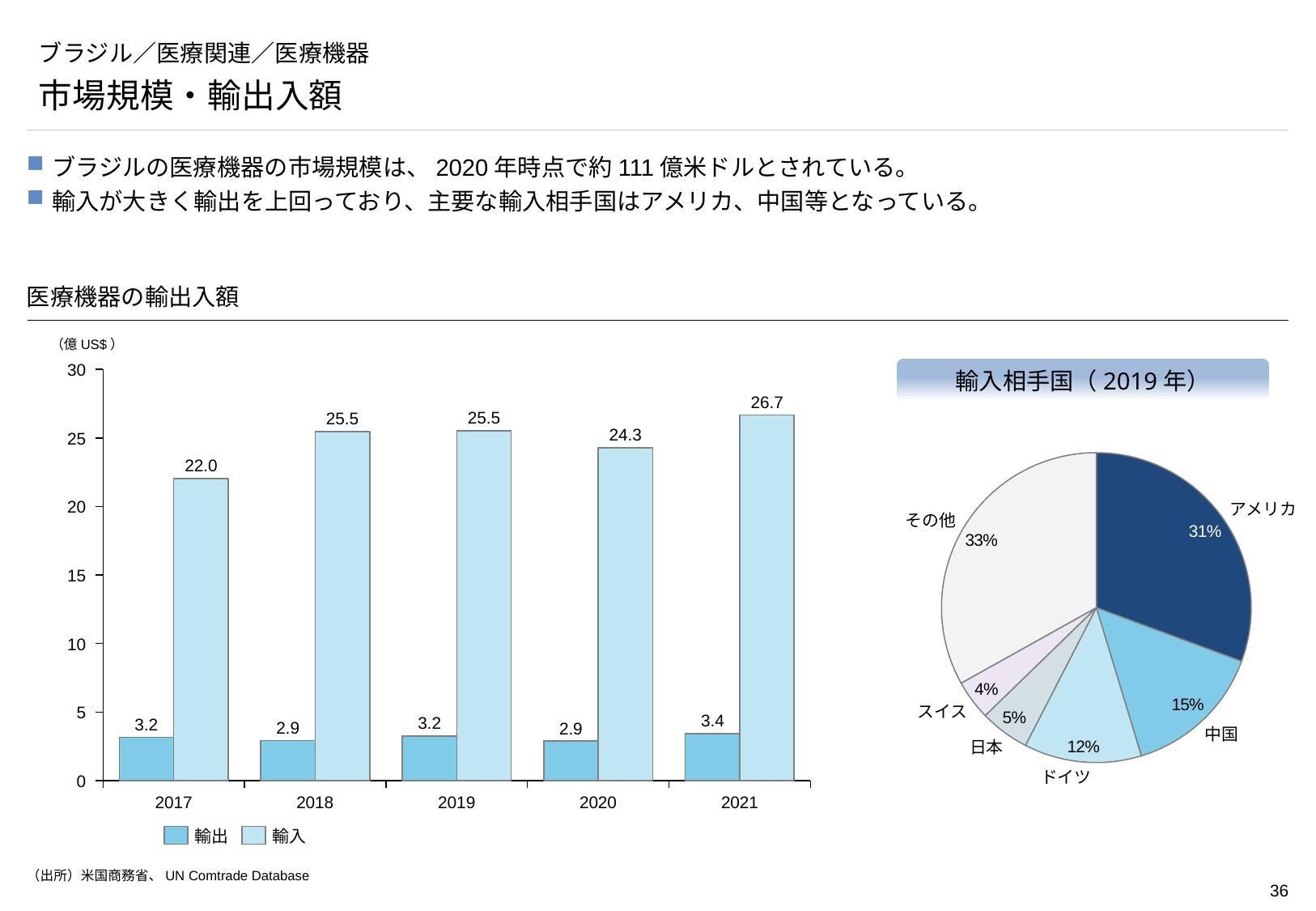
In the bar chart 医療機器の輸出入額, which year has the highest 輸入 value? 2021 In the bar chart 医療機器の輸出入額, how many series does the legend list? 2 In the bar chart 医療機器の輸出入額, what is the 輸出 value for 2018? 2.9 What type of chart is 医療機器の輸出入額? bar chart In the bar chart 医療機器の輸出入額, is the 輸出 value for 2021 larger or smaller than the 輸出 value for 2019? larger In the bar chart 医療機器の輸出入額, which year has the lowest 輸入 value? 2017 In the pie chart 輸入相手国（2019年）, which named country has the smallest share? スイス In the bar chart 医療機器の輸出入額, what is the difference between 輸入 and 輸出 in 2020? 21.4 In the pie chart 輸入相手国（2019年）, what share does アメリカ have? 31% In the pie chart 輸入相手国（2019年）, how many slices are there? 6 In the bar chart 医療機器の輸出入額, how many years are shown on the x axis? 5 In the bar chart 医療機器の輸出入額, what is the 輸入 value for 2021? 26.7